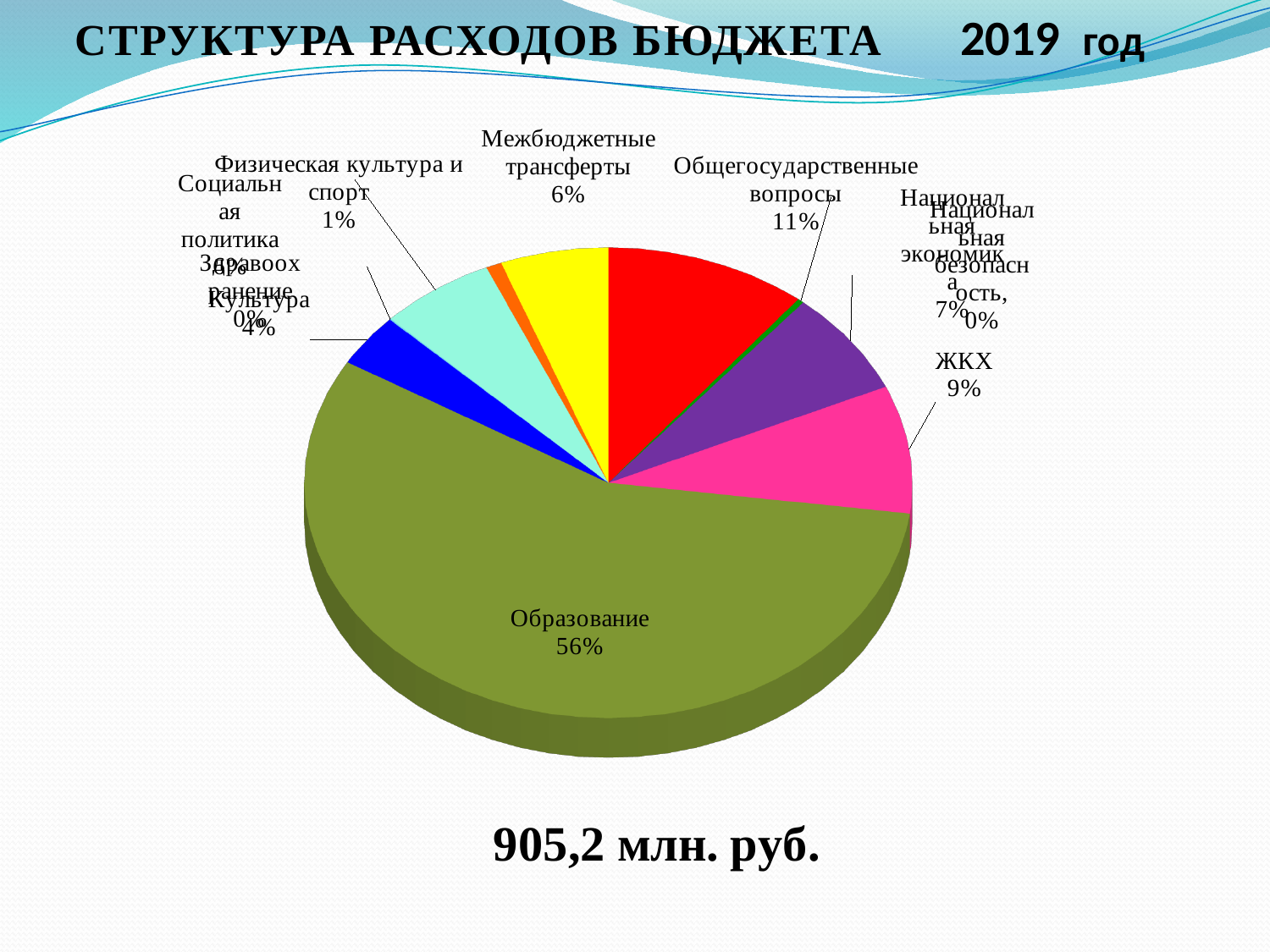
What share of budget expenditure goes to ЖКХ? 9% What share of budget expenditure goes to Национальная экономика? 7% What share of budget expenditure goes to Общегосударственные вопросы? 11% What is the difference in percentage points between the shares for Образование and Общегосударственные вопросы? 45 Which is larger: the share for ЖКХ or the share for Межбюджетные трансферты? ЖКХ What share of budget expenditure goes to Межбюджетные трансферты? 6% What total amount of budget expenditure is stated below the chart? 905,2 млн. руб. What share of budget expenditure goes to Образование? 56% What share of budget expenditure goes to Физическая культура и спорт? 1% What kind of chart is shown on the slide? pie chart Which year does the chart title refer to? 2019 Which category has the largest share of budget expenditure? Образование